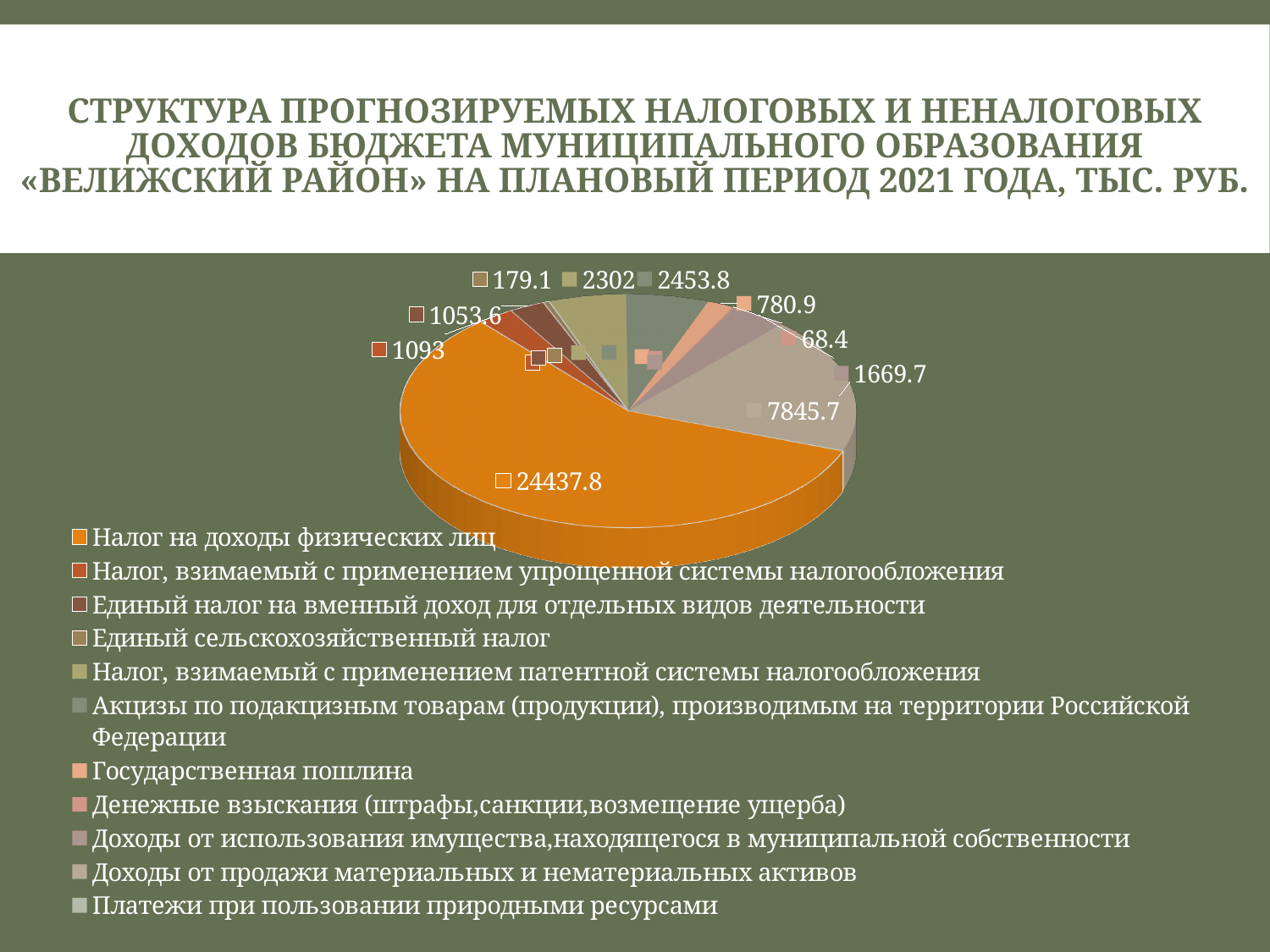
What is the value labelled for Государственная пошлина? 780.9 What is the smallest value printed as a data label on the pie chart? 68.4 What kind of chart is shown on the slide? pie chart What is the value shown for the largest slice of the pie chart? 24437.8 Which category has the largest slice in the pie chart? Налог на доходы физических лиц What is the difference between the slice labelled 24437.8 and the slice labelled 7845.7? 16592.1 In what units are the values in the chart given, according to the slide title? тыс. руб. What is the difference between the slices labelled 1093 and 1053.6? 39.4 Which legend entry is shown in orange, matching the largest slice? Налог на доходы физических лиц What is the value labelled for Доходы от продажи материальных и нематериальных активов? 7845.7 How many categories does the legend of the pie chart list? 11 Which is larger: the slice labelled 2453.8 or the slice labelled 2302? 2453.8